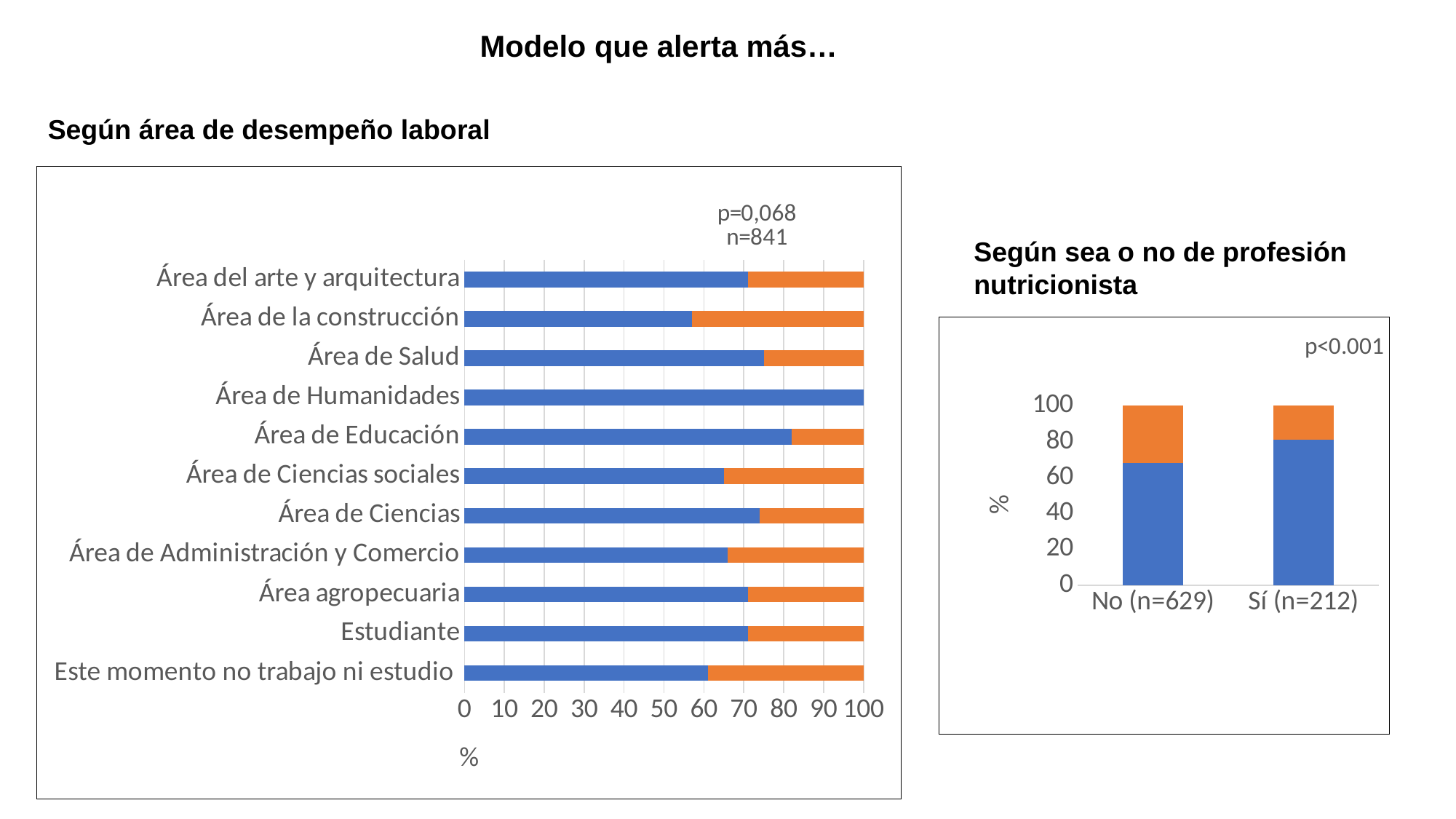
On the 'Según área de desempeño laboral' chart, is the blue segment for Área de Educación greater or less than 80? greater On the 'Según sea o no de profesión nutricionista' chart, is the blue segment for No (n=629) greater or less than 60? greater On the 'Según sea o no de profesión nutricionista' chart, which category has the larger blue segment, No (n=629) or Sí (n=212)? Sí (n=212) On the 'Según área de desempeño laboral' chart, is the blue segment for Área de Salud greater or less than 70? greater On the 'Según área de desempeño laboral' chart, which category has the largest blue segment? Área de Humanidades What p-value is printed on the 'Según sea o no de profesión nutricionista' chart? p<0.001 On the 'Según área de desempeño laboral' chart, which has a larger blue segment, Área de Educación or Área de la construcción? Área de Educación What kind of chart is the 'Según área de desempeño laboral' chart? bar chart What kind of chart is the 'Según sea o no de profesión nutricionista' chart? bar chart How many categories are shown on the 'Según sea o no de profesión nutricionista' chart? 2 How many categories are shown on the 'Según área de desempeño laboral' chart? 11